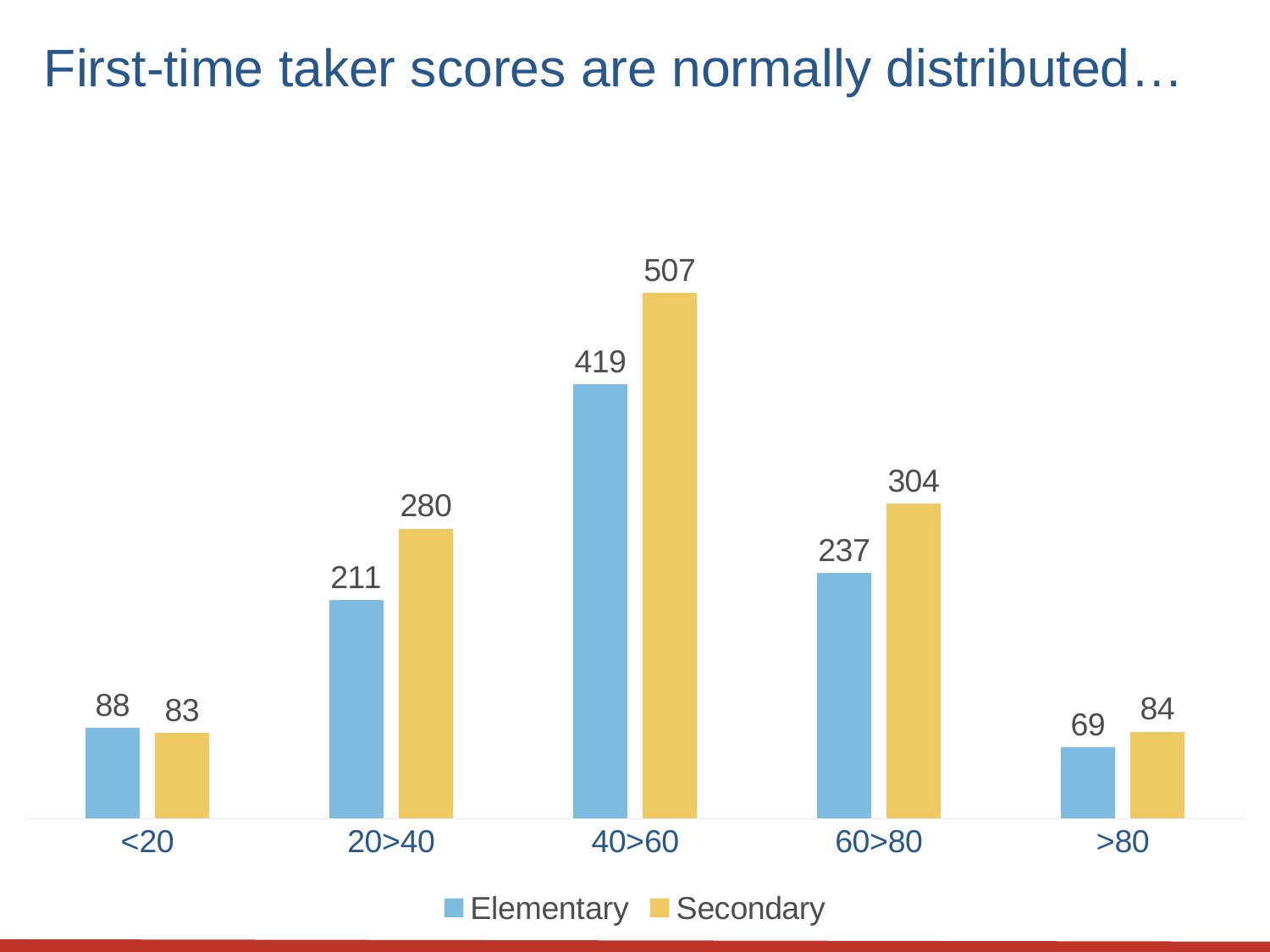
What is the Secondary value for the 20>40 score range? 280 What is the Elementary value for the 40>60 score range? 419 For the <20 score range, which series has the larger value, Elementary or Secondary? Elementary What kind of chart is shown on the slide? Bar chart What is the Secondary value for the >80 score range? 84 What is the difference between the Secondary values for 60>80 and 20>40? 24 Which score range has the lowest Elementary value? >80 How many score ranges are shown on the x axis? 5 What is the title of the slide? First-time taker scores are normally distributed… Which score range has the highest Secondary value? 40>60 What is the difference between the Secondary and Elementary values for the 40>60 range? 88 How many series does the legend list? 2